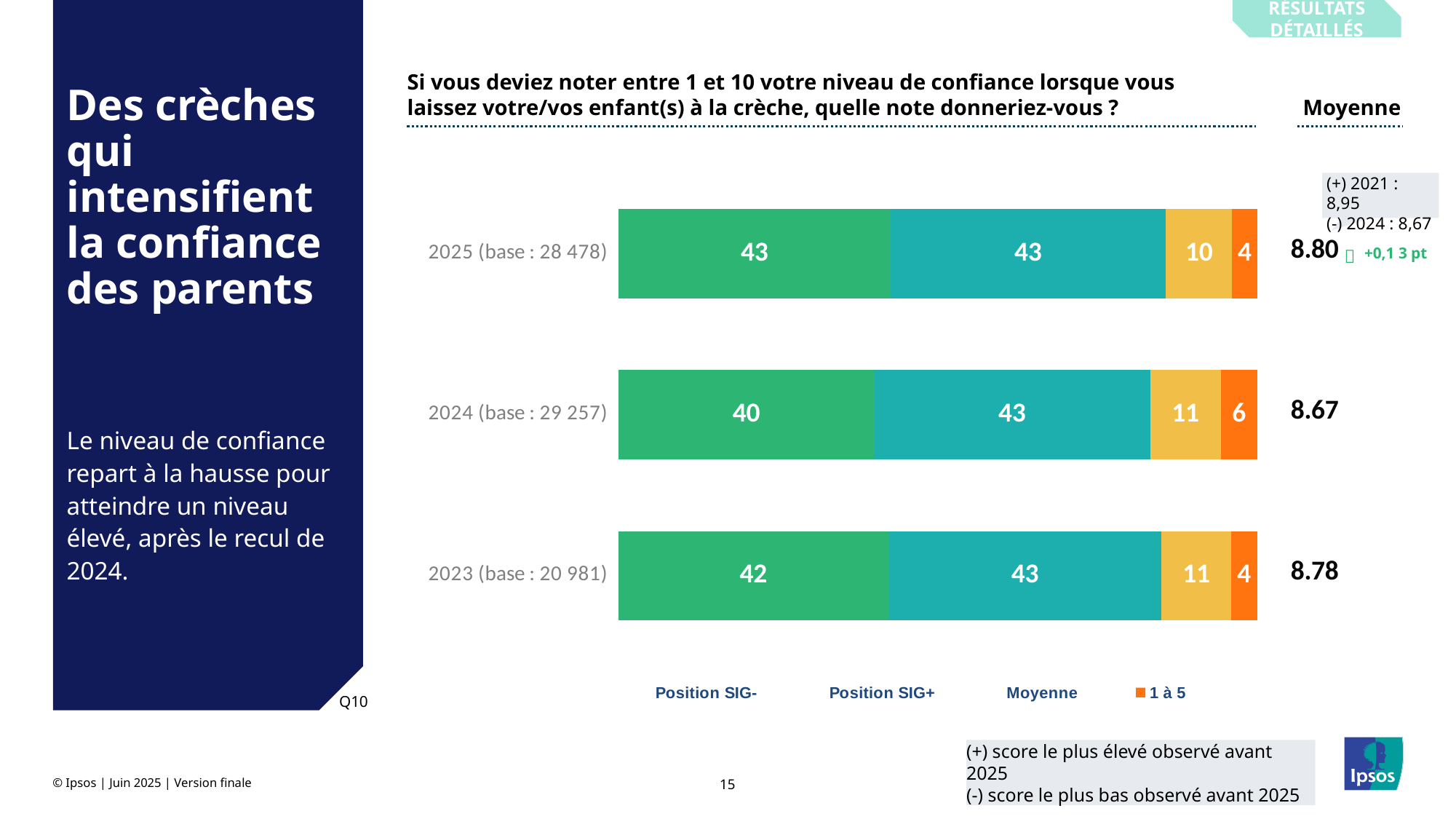
What is the value of the orange '1 à 5' segment for 2024? 6 Which year has the lowest mean score shown on the right? 2024 What kind of chart is shown on the slide? Stacked bar chart Which year has the larger orange '1 à 5' segment, 2024 or 2023? 2024 What is the value of the green (first) segment for 2024? 40 How many series does the legend list? 4 Which year has the highest mean score shown on the right? 2025 What is the total of the stacked bar for 2025? 100 What is the base (sample size) shown for 2025? 28 478 What is the 'Moyenne' (mean score) shown for 2025? 8.80 How many bars (years) does the chart show? 3 What is the difference between the green (first) segment values for 2025 and 2024? 3